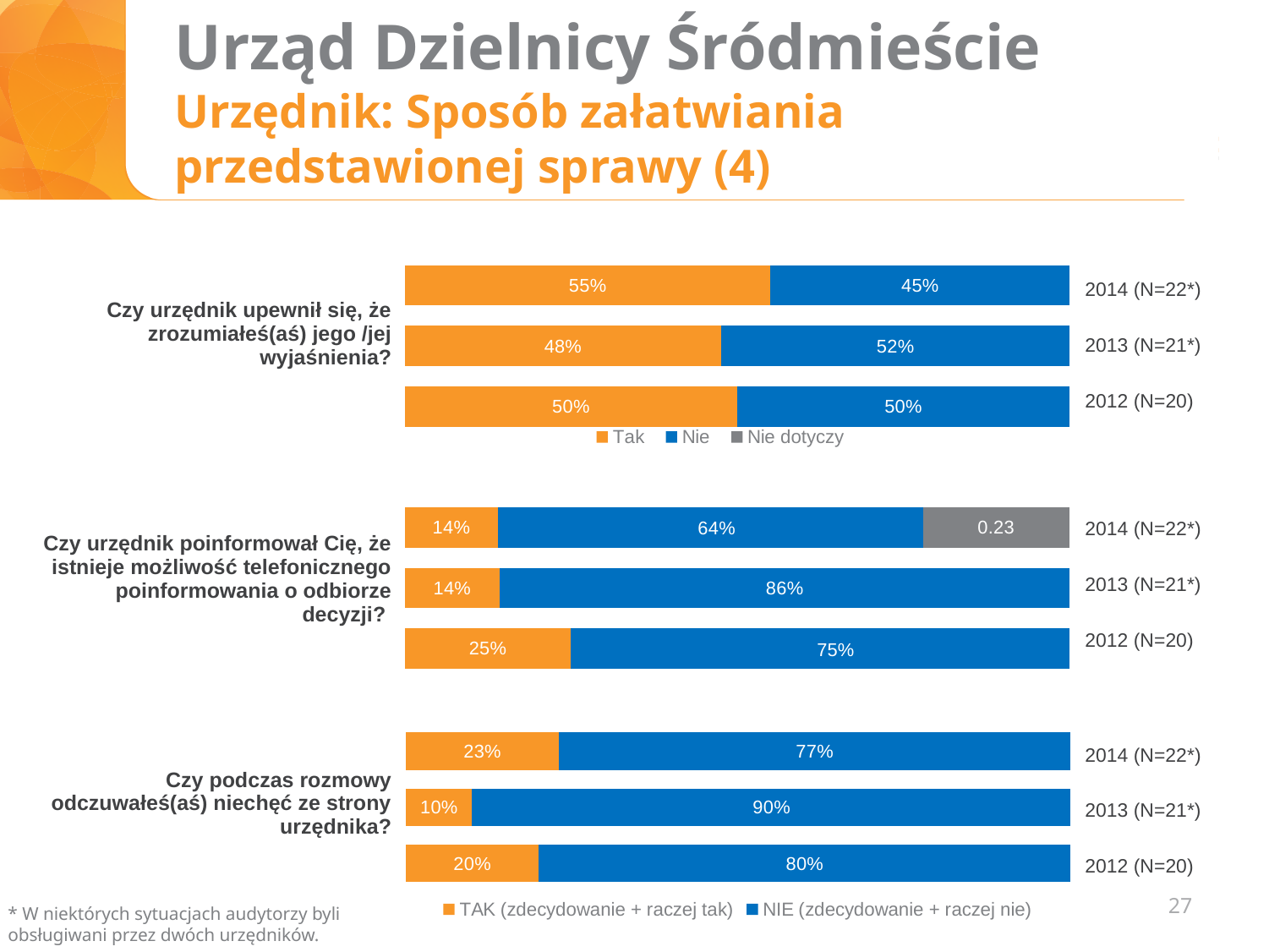
In the chart for "Czy urzędnik poinformował Cię, że istnieje możliwość telefonicznego poinformowania o odbiorze decyzji?", which year has the highest Tak value? 2012 (N=20) In the chart for "Czy urzędnik upewnił się, że zrozumiałeś(aś) jego /jej wyjaśnienia?", what is the Nie value for 2013 (N=21*)? 52% In the chart for "Czy podczas rozmowy odczuwałeś(aś) niechęć ze strony urzędnika?", what is the NIE value for 2013 (N=21*)? 90% In the chart for "Czy urzędnik upewnił się, że zrozumiałeś(aś) jego /jej wyjaśnienia?", what is the Tak value for 2014 (N=22*)? 55% In the chart for "Czy urzędnik upewnił się, że zrozumiałeś(aś) jego /jej wyjaśnienia?", which year has the highest Tak value? 2014 (N=22*) In the chart for "Czy podczas rozmowy odczuwałeś(aś) niechęć ze strony urzędnika?", is the TAK value larger for 2014 (N=22*) or 2012 (N=20)? 2014 (N=22*) In the chart for "Czy urzędnik poinformował Cię, że istnieje możliwość telefonicznego poinformowania o odbiorze decyzji?", what is the Nie value for 2013 (N=21*)? 86% In the chart for "Czy urzędnik poinformował Cię, że istnieje możliwość telefonicznego poinformowania o odbiorze decyzji?", what is the grey Nie dotyczy value shown for 2014 (N=22*)? 0.23 In the chart for "Czy urzędnik poinformował Cię, że istnieje możliwość telefonicznego poinformowania o odbiorze decyzji?", what is the difference between the Nie values for 2013 (N=21*) and 2012 (N=20)? 11% In the chart for "Czy podczas rozmowy odczuwałeś(aś) niechęć ze strony urzędnika?", which year has the lowest TAK value? 2013 (N=21*) In the chart for "Czy urzędnik upewnił się, że zrozumiałeś(aś) jego /jej wyjaśnienia?", how many entries does the legend list? 3 What type of chart is used for "Czy podczas rozmowy odczuwałeś(aś) niechęć ze strony urzędnika?"? Stacked bar chart